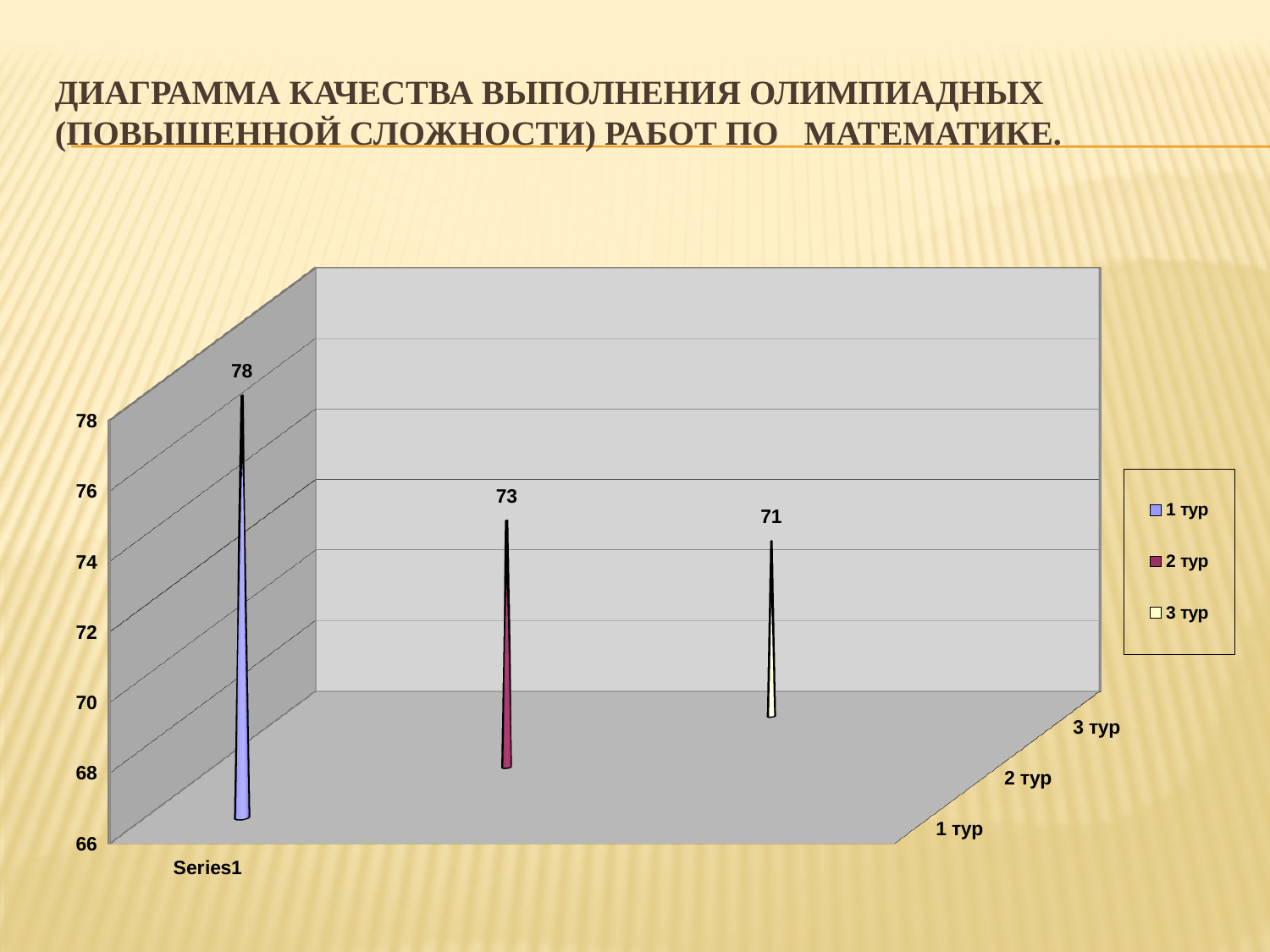
Which is larger, the value for 1 тур or the value for 2 тур? 1 тур What is the value for 1 тур? 78 How many series does the legend list? 3 Which series has the highest value? 1 тур Is the value for 2 тур greater or less than 70? greater What is the category label shown on the horizontal axis? Series1 What is the difference between the values for 1 тур and 3 тур? 7 Which series has the lowest value? 3 тур What is the difference between the values for 2 тур and 3 тур? 2 What kind of chart is shown on the slide? bar chart What is the value for 3 тур? 71 What is the value for 2 тур? 73